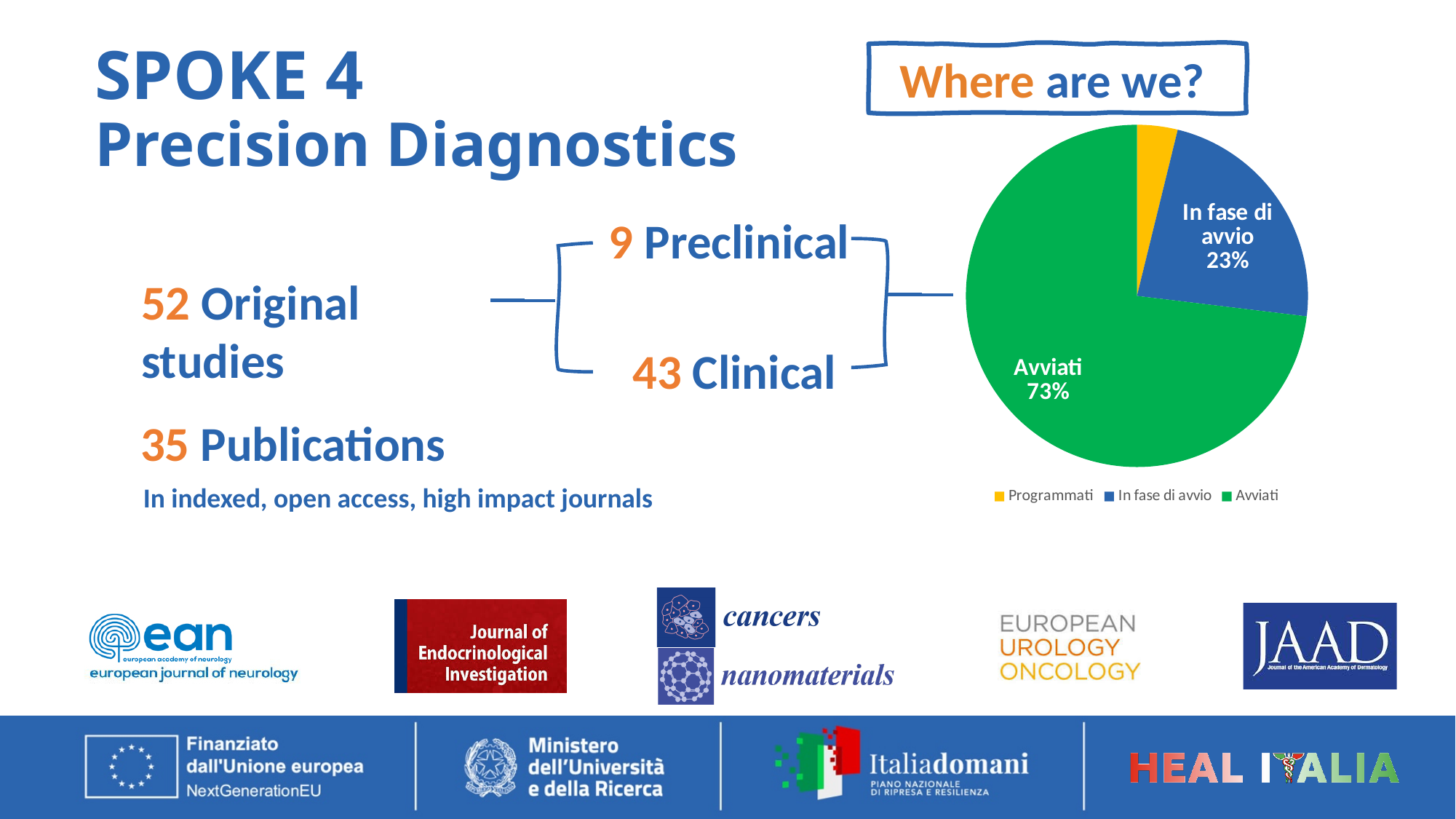
Is the share for Avviati greater or less than 50%? greater What is the difference in percentage points between the Avviati share and the In fase di avvio share? 50 What colour is the Programmati slice in the pie chart? yellow Which category has the largest slice of the pie? Avviati How many categories does the pie chart legend list? 3 Which is larger, the Programmati slice or the In fase di avvio slice? In fase di avvio Which is larger, the Avviati slice or the In fase di avvio slice? Avviati What share of the pie does the In fase di avvio slice represent? 23% What kind of chart is shown on the slide? pie chart Which category has the smallest slice of the pie? Programmati What share of the pie does the Avviati slice represent? 73% What colour is the Avviati slice in the pie chart? green